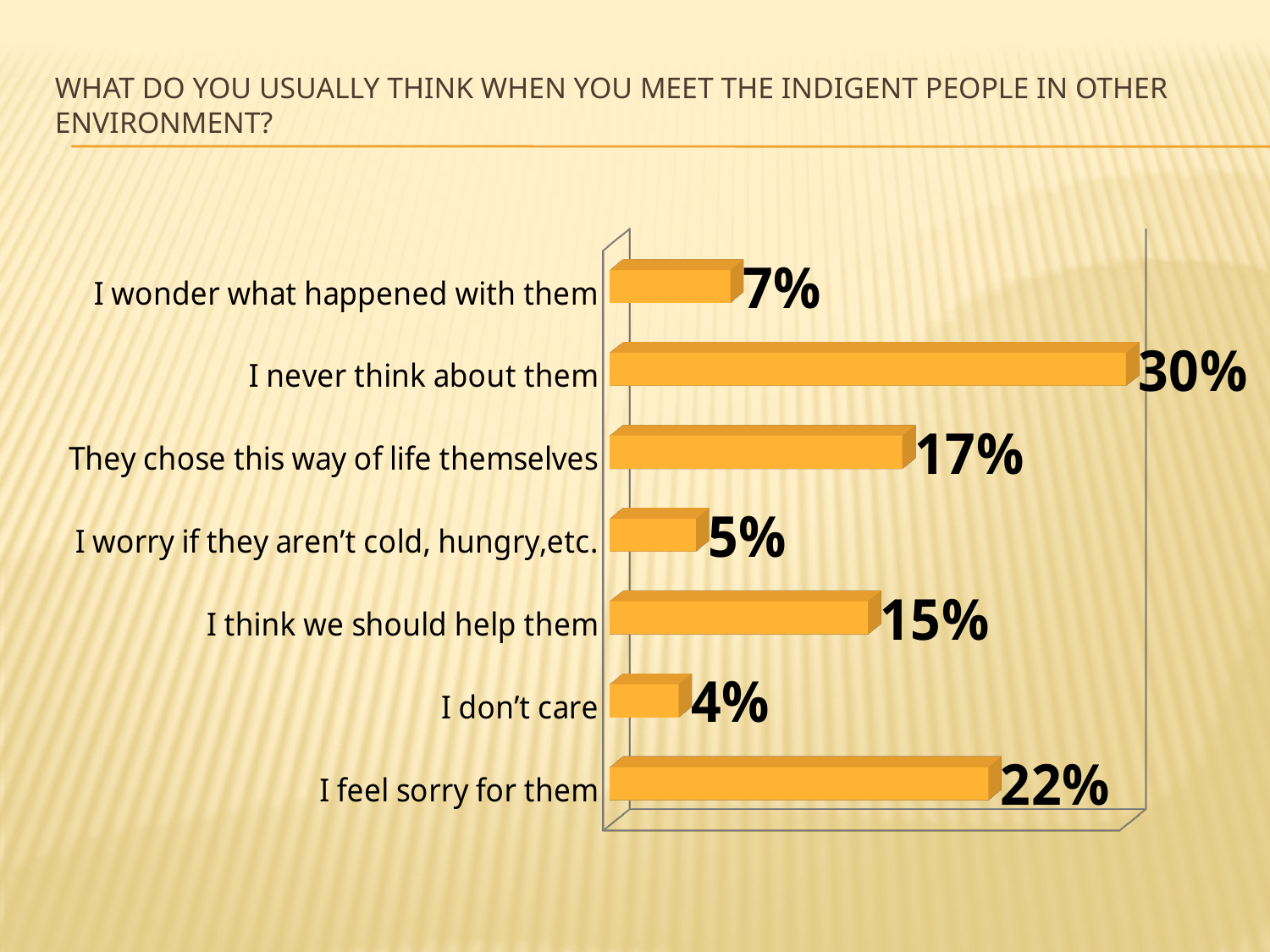
What is the difference between "They chose this way of life themselves" and "I think we should help them"? 2% What is the value for "I think we should help them"? 15% Which is larger: "I wonder what happened with them" or "I don't care"? I wonder what happened with them What kind of chart is shown on the slide? Bar chart Which response has the lowest percentage? I don't care What is the difference between "I never think about them" and "I feel sorry for them"? 8% Which response has the highest percentage? I never think about them How many response categories are shown in the chart? 7 What is the value for "I feel sorry for them"? 22% What is the value for "I worry if they aren't cold, hungry,etc."? 5% What colour are the bars in the chart? Orange What percentage of respondents said "I never think about them"? 30%